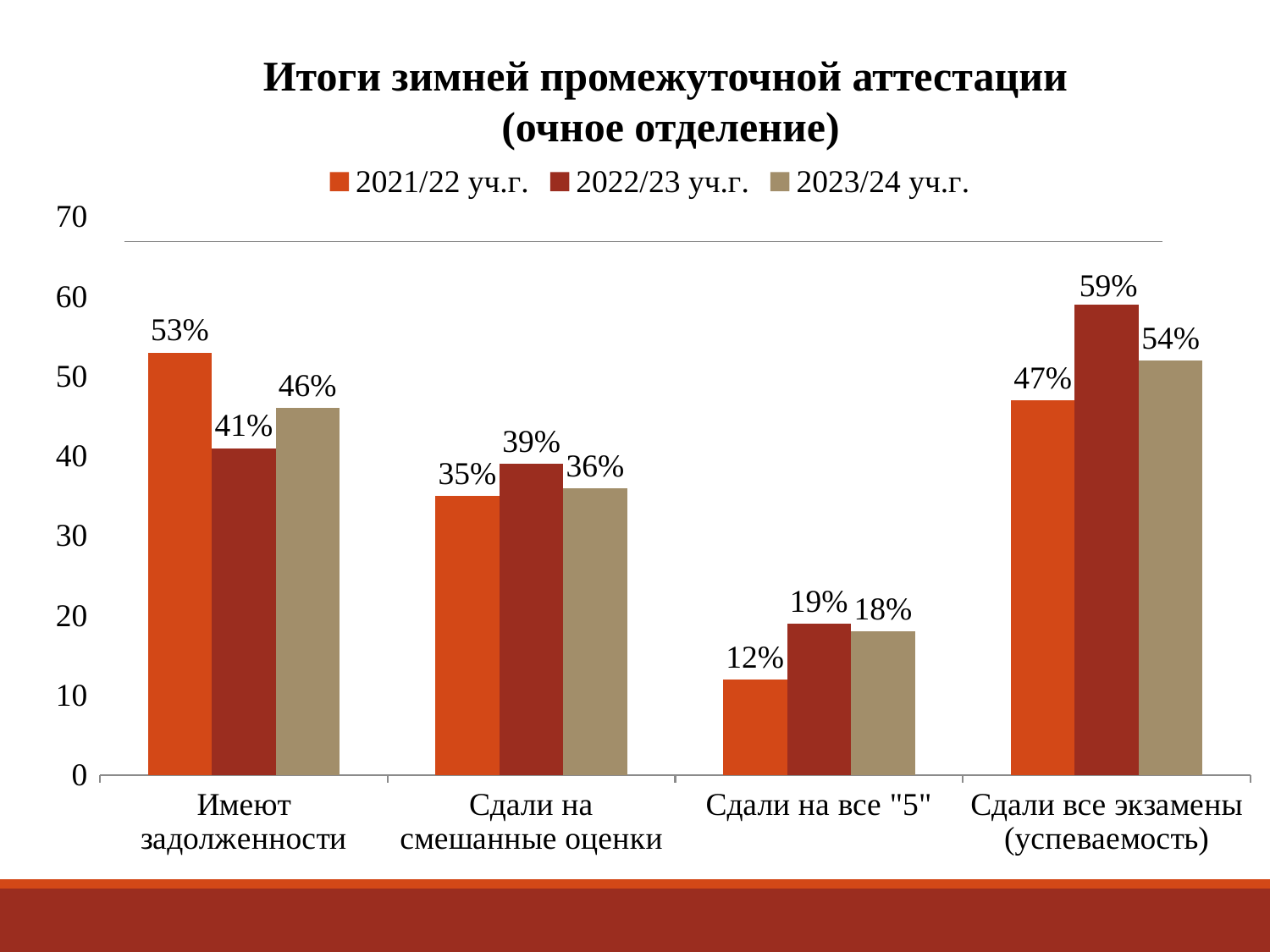
What is the value for 2021/22 уч.г. in the category Имеют задолженности? 53% What is the value for 2022/23 уч.г. in the category Сдали на все "5"? 19% Which series has the highest value in the category Сдали все экзамены (успеваемость)? 2022/23 уч.г. How many series does the legend list? 3 What is the value for 2023/24 уч.г. in the category Сдали все экзамены (успеваемость)? 54% How many categories are shown on the x axis? 4 Which category has the lowest value for 2021/22 уч.г.? Сдали на все "5" Is the value for 2023/24 уч.г. in the category Сдали на все "5" greater or less than 20? less What is the difference between the 2021/22 уч.г. and 2022/23 уч.г. values in the category Имеют задолженности? 12% Which is larger in the category Сдали на смешанные оценки: the value for 2022/23 уч.г. or for 2023/24 уч.г.? 2022/23 уч.г. What kind of chart is shown on the slide? Bar chart What is the title of the chart? Итоги зимней промежуточной аттестации (очное отделение)